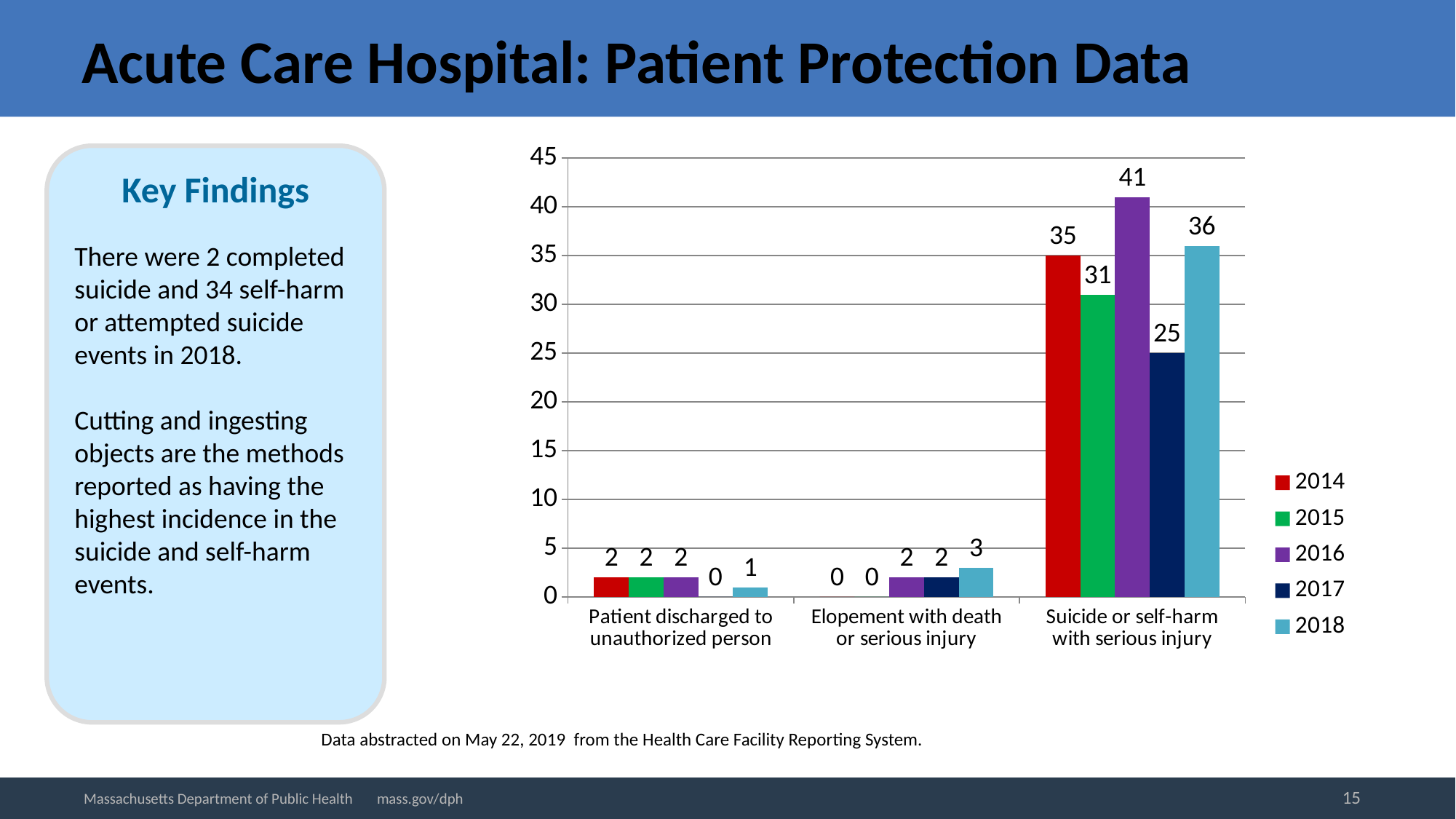
Which year has the lowest value in the 'Suicide or self-harm with serious injury' category? 2017 Which year is shown in red in the legend? 2014 Which year has the highest value in the 'Suicide or self-harm with serious injury' category? 2016 Is the value for 2015 in the 'Suicide or self-harm with serious injury' category greater or less than 30? greater How many categories are shown on the x axis of the chart? 3 What is the value for 2016 in the 'Suicide or self-harm with serious injury' category? 41 What is the value for 2017 in the 'Patient discharged to unauthorized person' category? 0 In the 'Suicide or self-harm with serious injury' category, which is larger: the value for 2014 or the value for 2018? 2018 How many series does the legend list? 5 What is the difference between the 2016 and 2017 values in the 'Suicide or self-harm with serious injury' category? 16 What kind of chart is shown on the slide? Bar chart What is the value for 2018 in the 'Elopement with death or serious injury' category? 3